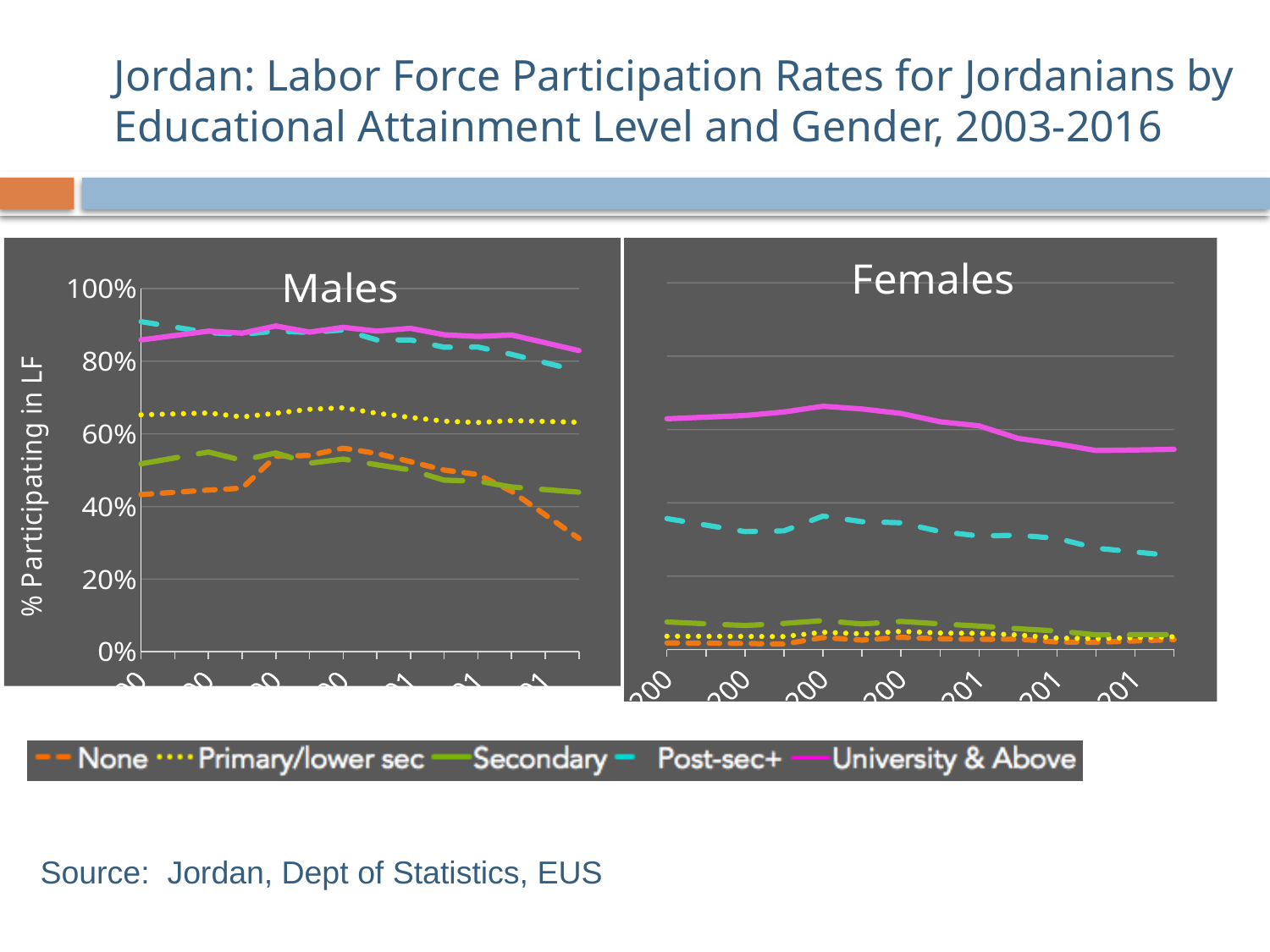
In the Females chart, is the value for Post-sec+ greater or less than 40% throughout the period? less In the Females chart, which series has the highest values throughout? University & Above In the Females chart, which is higher, University & Above or Post-sec+? University & Above In the Females chart, does the Post-sec+ line rise or fall over the period? fall In the Males chart, which series has the lowest value at the end of the period? None In the Males chart, does the None line rise or fall over the last few years of the period? fall In the Males chart, which is higher, Primary/lower sec or Secondary? Primary/lower sec What is the y-axis title of the charts? % Participating in LF What kind of chart is the Males chart? line chart In the Males chart, is the value for Primary/lower sec greater or less than 60% throughout the period? greater In the Females chart, is the value for Secondary greater or less than 20%? less How many series does the legend list? 5